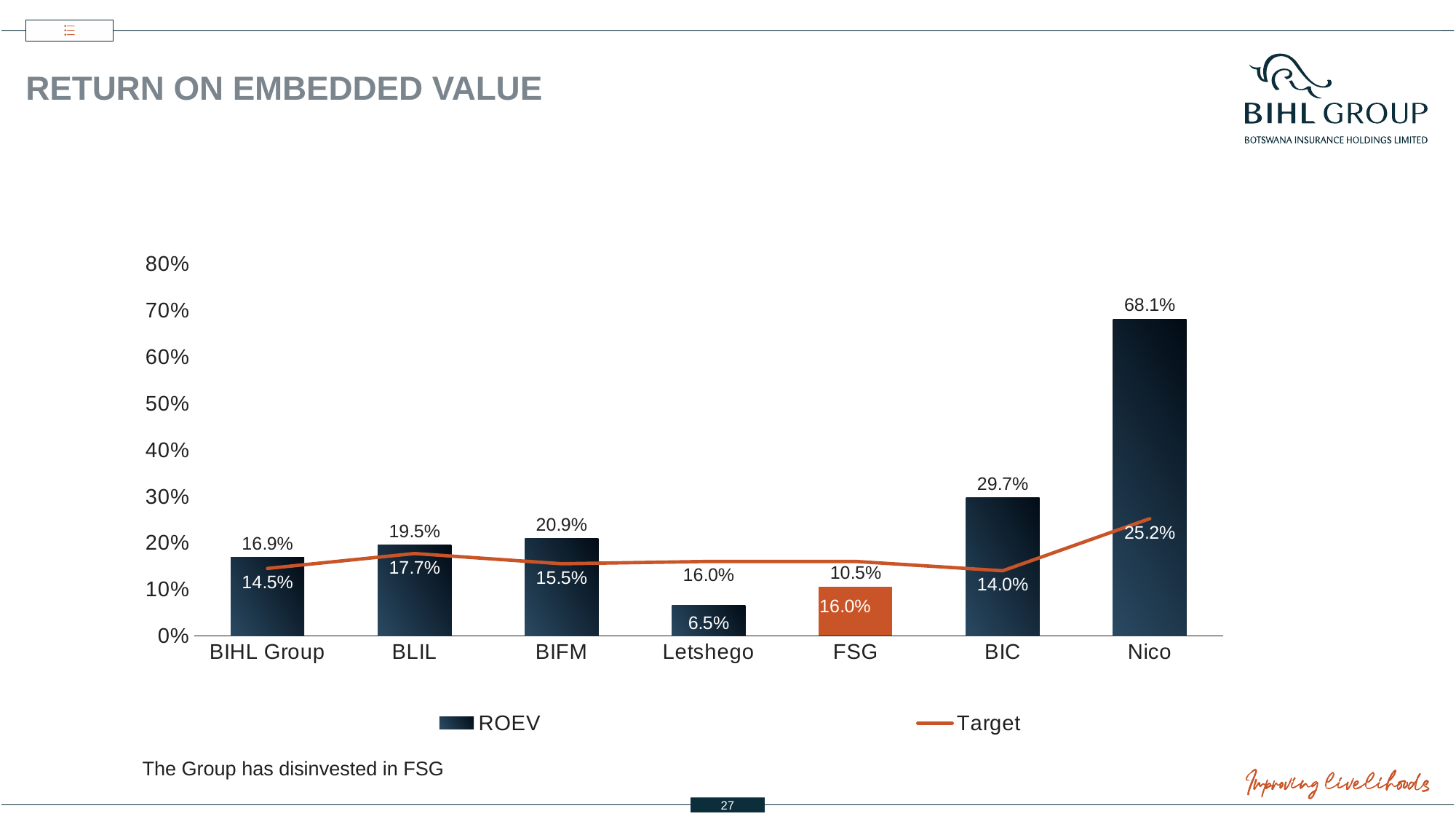
Which category has the lowest ROEV? Letshego Which category has the highest ROEV? Nico Which has a higher ROEV, BLIL or BIHL Group? BLIL How many series does the legend list? 2 What is the ROEV value for Nico? 68.1% What is the ROEV value for BIFM? 20.9% What is the difference between the ROEV values for Nico and BIC? 38.4% Which bar is coloured orange instead of dark blue? FSG Is the ROEV value for Nico greater or less than 60%? greater What is the ROEV value for BIC? 29.7% How many categories are shown on the x axis? 7 What is the Target value for Nico? 25.2%